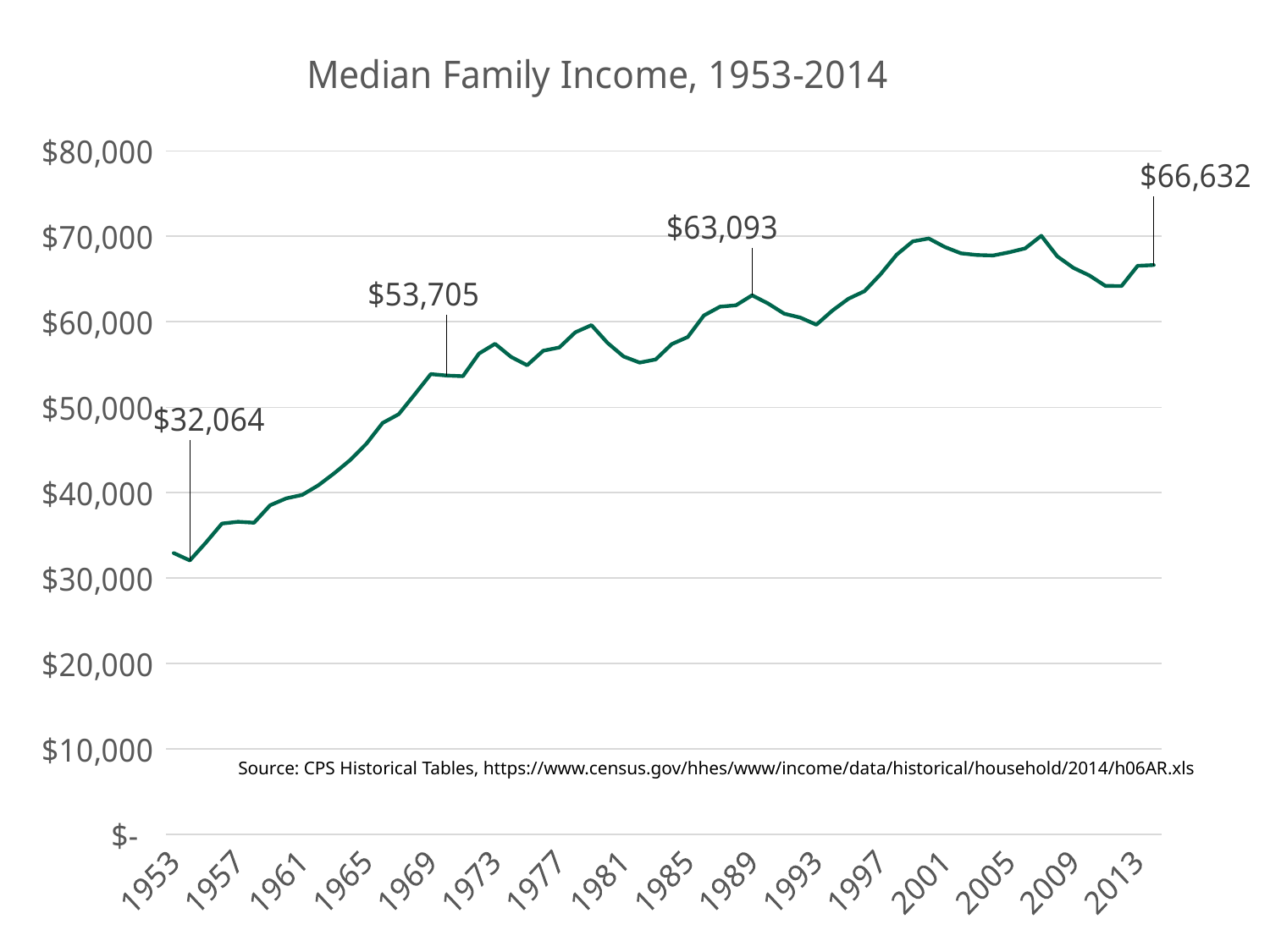
What is the data label shown at the end of the line, for 2014? $66,632 Which of the four labeled values on the chart is the lowest? $32,064 What is the title of the chart? Median Family Income, 1953-2014 What is the data label shown on the line near 1970? $53,705 What is the difference between the labeled value for 2014 ($66,632) and the labeled value near 1989 ($63,093)? $3,539 Overall, does median family income rise or fall from 1953 to 2014? rise What is the difference between the labeled value near 1989 ($63,093) and the labeled value near 1970 ($53,705)? $9,388 Which of the four labeled values on the chart is the highest? $66,632 What is the data label shown near the start of the line, at the dip just after 1953? $32,064 What is the data label shown on the line near 1989? $63,093 Is the value for 1953 greater or less than $40,000? less What kind of chart is shown on the slide? line chart